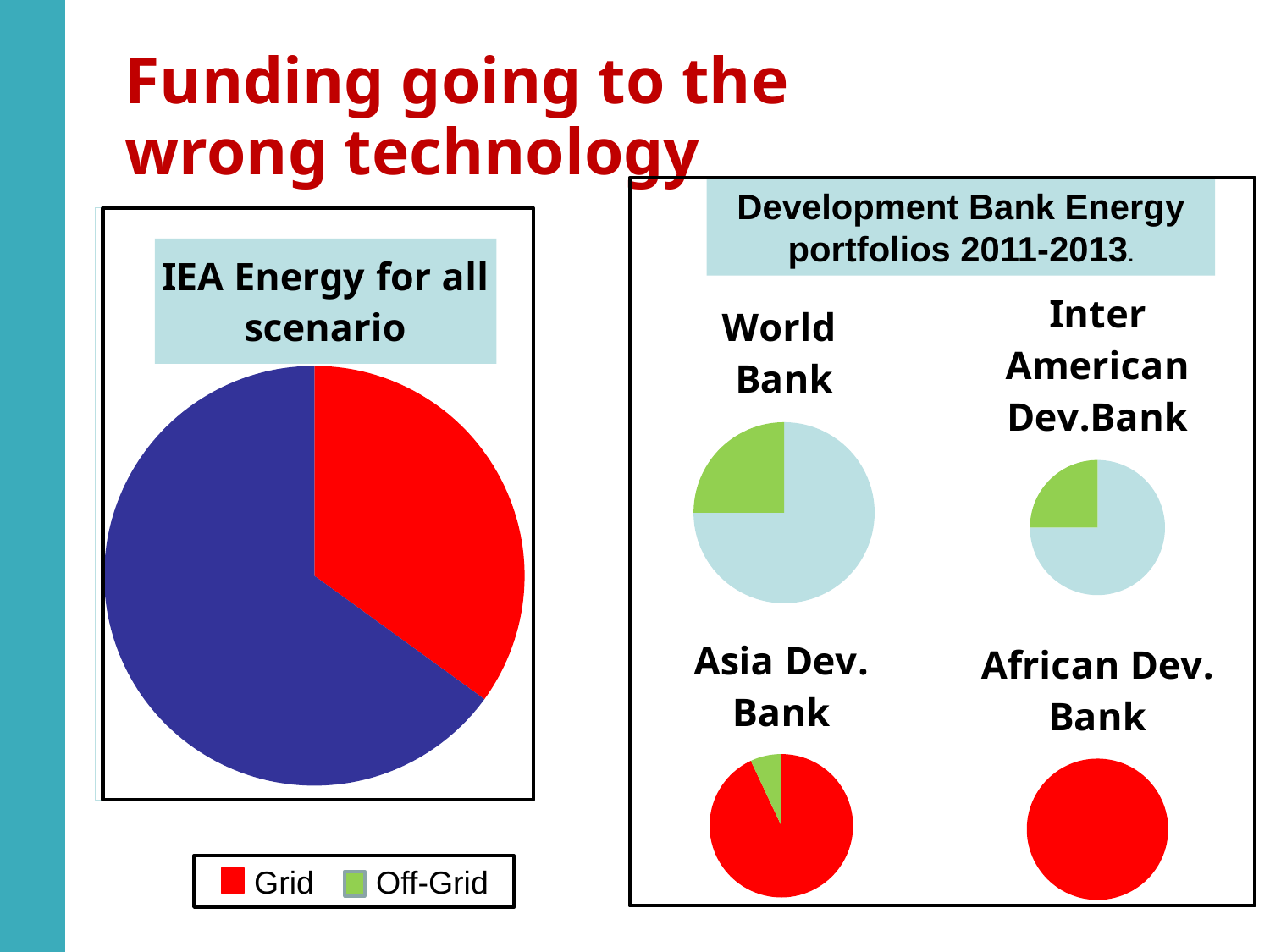
In the legend at the bottom left of the slide, which colour represents 'Off-Grid'? green What kind of chart is the 'IEA Energy for all scenario' chart? pie chart In the 'Development Bank Energy portfolios 2011-2013' panel, which bank's pie chart is entirely red (Grid)? African Dev. Bank In the 'IEA Energy for all scenario' pie chart, which slice is larger, the blue slice or the red slice? the blue slice What kind of chart is used for each bank in the 'Development Bank Energy portfolios 2011-2013' panel? pie chart In the 'Inter American Dev.Bank' pie chart, which slice is larger, the green slice or the light blue slice? the light blue slice In the 'Asia Dev. Bank' pie chart, which slice is larger, the red (Grid) slice or the green (Off-Grid) slice? the red (Grid) slice In the 'IEA Energy for all scenario' pie chart, how many slices are there? 2 How many pie charts are shown in the 'Development Bank Energy portfolios 2011-2013' panel? 4 In the legend at the bottom left of the slide, which colour represents 'Grid'? red How many entries does the legend at the bottom left of the slide list? 2